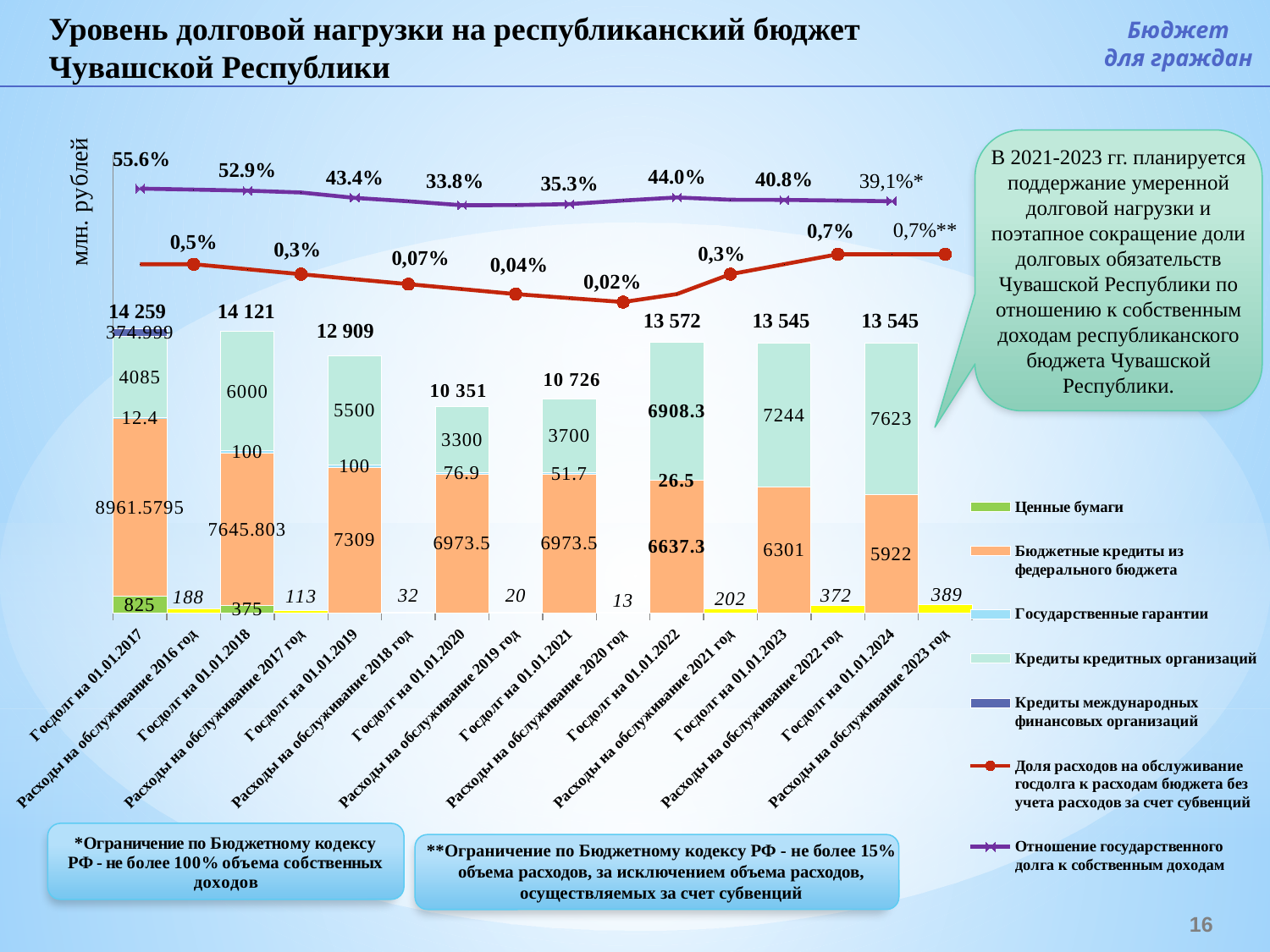
Каковы расходы на обслуживание госдолга за 2022 год? 372 На сколько общий объём госдолга на 01.01.2017 больше, чем на 01.01.2018? 138 В какую дату общий объём госдолга (подпись над столбцом) был наименьшим? 01.01.2020 Что больше: бюджетные кредиты из федерального бюджета на 01.01.2019 или на 01.01.2023? на 01.01.2019 Как изменяется отношение государственного долга к собственным доходам с 01.01.2017 по 01.01.2020? снижается Каково значение показателя «Отношение государственного долга к собственным доходам» на 01.01.2017? 55.6% Какого типа диаграмма на слайде? комбинированная: столбчатая (с накоплением) и линейная Сколько записей содержит легенда диаграммы? 7 Какова доля расходов на обслуживание госдолга к расходам бюджета без учёта субвенций за 2020 год? 0,02% Каков объём кредитов кредитных организаций в составе госдолга на 01.01.2024? 7623 В какую дату отношение государственного долга к собственным доходам было наибольшим? 01.01.2017 Каков общий объём госдолга на 01.01.2020 (подпись над столбцом)? 10 351